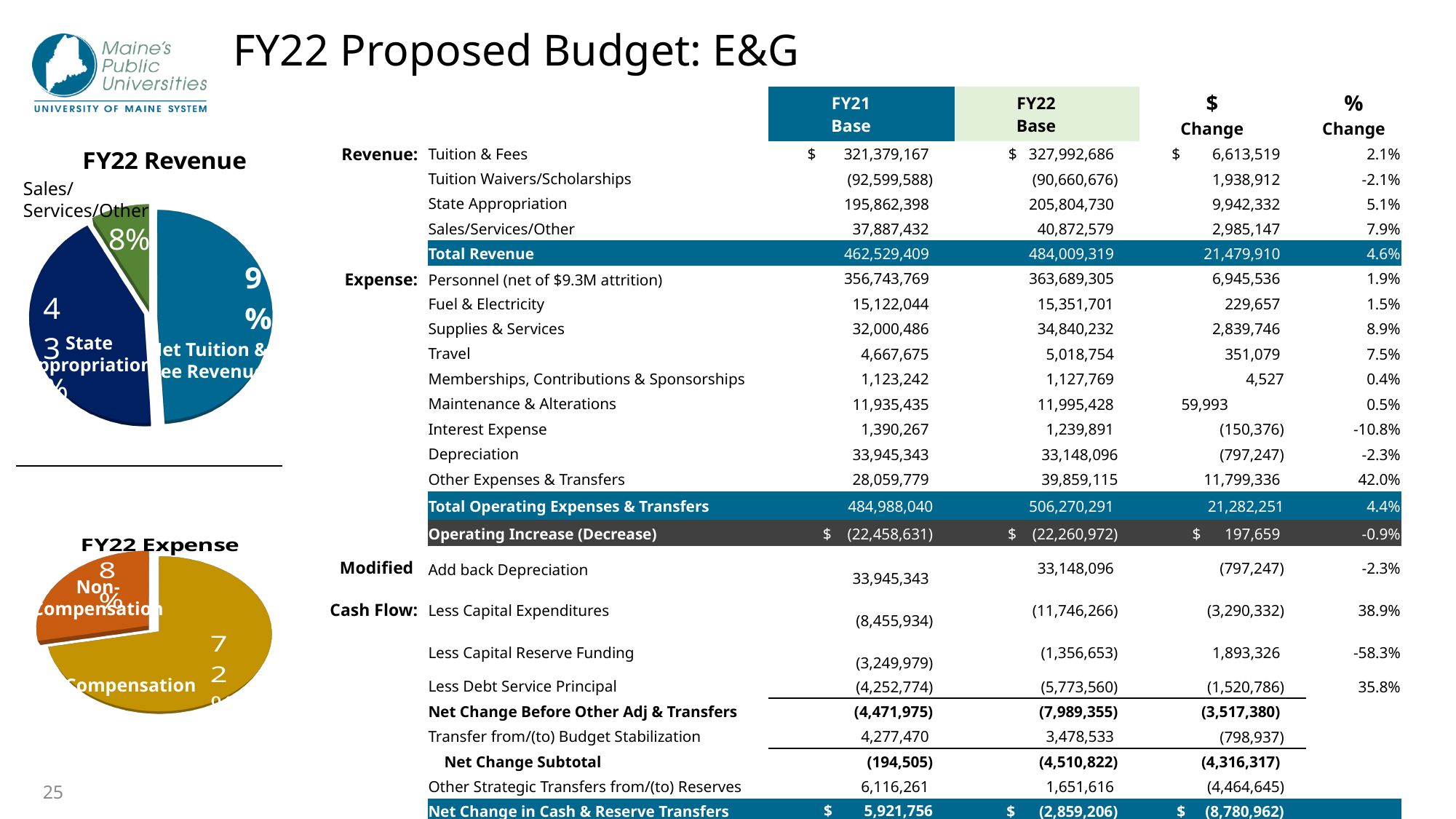
What kind of chart is the FY22 Revenue chart? pie chart In the FY22 Revenue pie chart, what colour is the Sales/Services/Other slice? green What is the title of the upper pie chart on the slide? FY22 Revenue In the FY22 Revenue pie chart, what share does Sales/Services/Other have? 8% In the FY22 Revenue pie chart, which slice is the smallest? Sales/Services/Other In the FY22 Expense pie chart, which slice is the largest? Compensation What kind of chart is the FY22 Expense chart? pie chart In the FY22 Revenue pie chart, which is larger: State Appropriation or Sales/Services/Other? State Appropriation How many slices does the FY22 Expense pie chart have? 2 In the FY22 Expense pie chart, which slice is the smallest? Non-Compensation How many slices does the FY22 Revenue pie chart have? 3 In the FY22 Revenue pie chart, which slice is the largest? Net Tuition & Fee Revenue